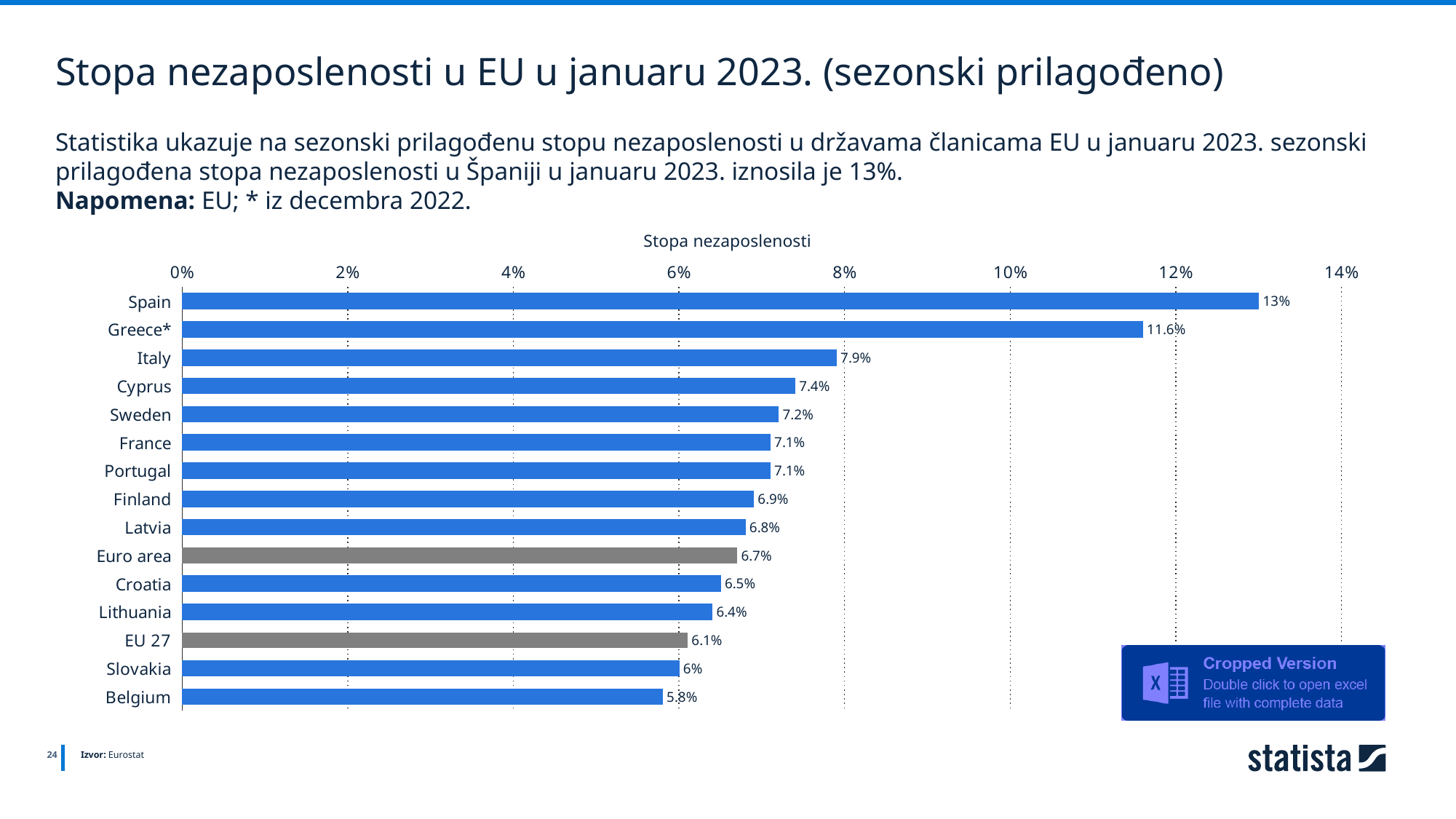
What kind of chart is shown on the slide? Bar chart Which category has the highest unemployment rate on the chart? Spain What is the unemployment rate shown for Spain? 13% How many categories are shown on the chart? 15 What is the unemployment rate shown for EU 27? 6.1% Which category has the lowest unemployment rate on the chart? Belgium What is the unemployment rate shown for Greece*? 11.6% Is the value for Italy greater or less than 8%? less Which two bars on the chart are coloured grey instead of blue? Euro area and EU 27 What is the difference between the unemployment rates of Spain and Greece*? 1.4% Which has a higher unemployment rate, Italy or Cyprus? Italy What is the unemployment rate shown for the Euro area? 6.7%